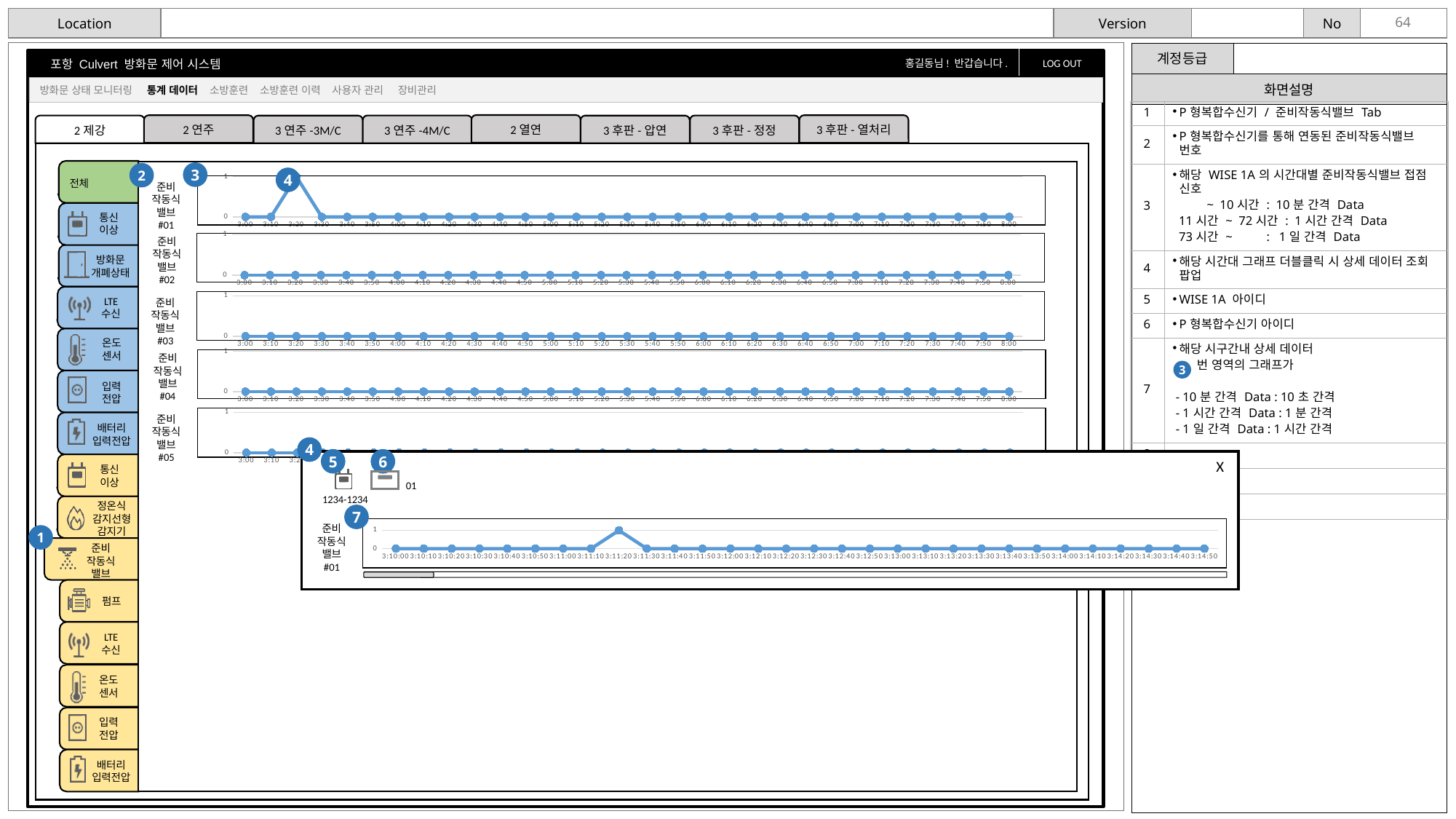
In the 준비작동식밸브 #01 chart in the main panel, which is larger, the value at 3:20 or the value at 3:30? 3:20 What is the maximum y-axis tick shown on the 준비작동식밸브 #03 chart in the main panel? 1 What is the first x-axis label on the popup chart (준비작동식밸브 #01)? 3:10:00 In the 준비작동식밸브 #01 chart in the main panel, what is the value at 3:20? 1 In the 준비작동식밸브 #02 chart in the main panel, do the values rise, fall, or stay flat across the x axis? stay flat Which of the five main-panel charts shows a spike to 1? 준비작동식밸브 #01 What kind of chart is used for 준비작동식밸브 #01 in the main panel? line chart In the popup chart (준비작동식밸브 #01), at which time does the value reach 1? 3:11:20 In the popup chart (준비작동식밸브 #01), what is the value at 3:10:00? 0 In the main panel, how many 준비작동식밸브 charts are stacked vertically? 5 In the 준비작동식밸브 #01 chart in the main panel, at which time is the value highest? 3:20 In the 준비작동식밸브 #01 chart in the main panel, what is the value at 3:00? 0